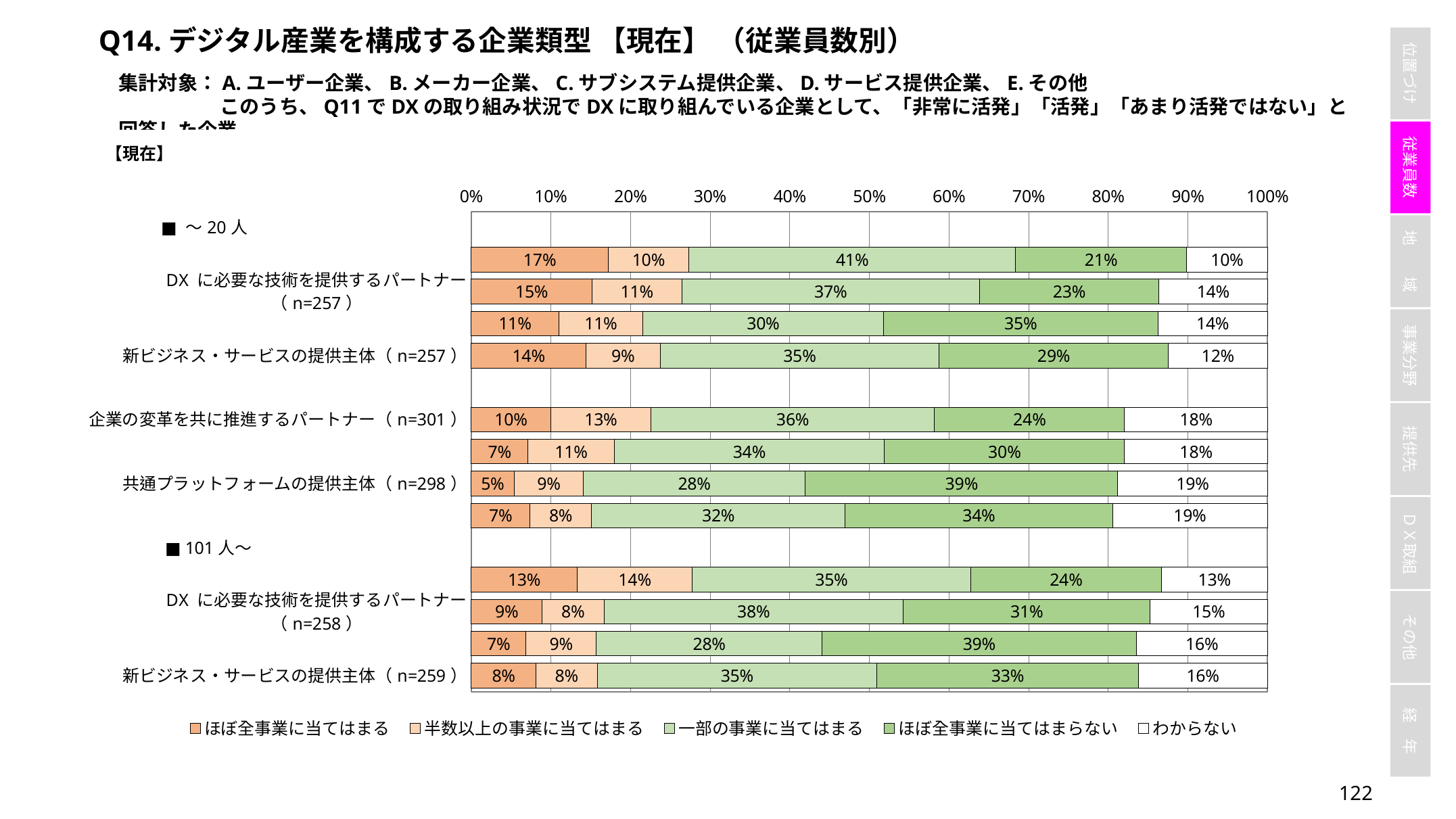
How many series does the legend list? 5 What kind of chart is shown on the slide? Stacked bar chart What is the maximum value shown on the horizontal axis? 100% For 企業の変革を共に推進するパートナー (n=301), what is the value for わからない? 18% In the bar for 共通プラットフォームの提供主体 (n=298), which response category has the largest share? ほぼ全事業に当てはまらない Which has the larger ほぼ全事業に当てはまる value: DX に必要な技術を提供するパートナー (n=257) or DX に必要な技術を提供するパートナー (n=258)? DX に必要な技術を提供するパートナー (n=257) How many bars are shown in the ～20人 group? 4 For 企業の変革を共に推進するパートナー (n=301), how much larger is 一部の事業に当てはまる than ほぼ全事業に当てはまらない? 12 percentage points For 共通プラットフォームの提供主体 (n=298), what is the value for ほぼ全事業に当てはまらない? 39% What is the total of all segments in the bar for 新ビジネス・サービスの提供主体 (n=259)? 100% For 新ビジネス・サービスの提供主体 (n=259), what is the value for 一部の事業に当てはまる? 35% For 新ビジネス・サービスの提供主体 (n=257), what is the value for ほぼ全事業に当てはまる? 14%